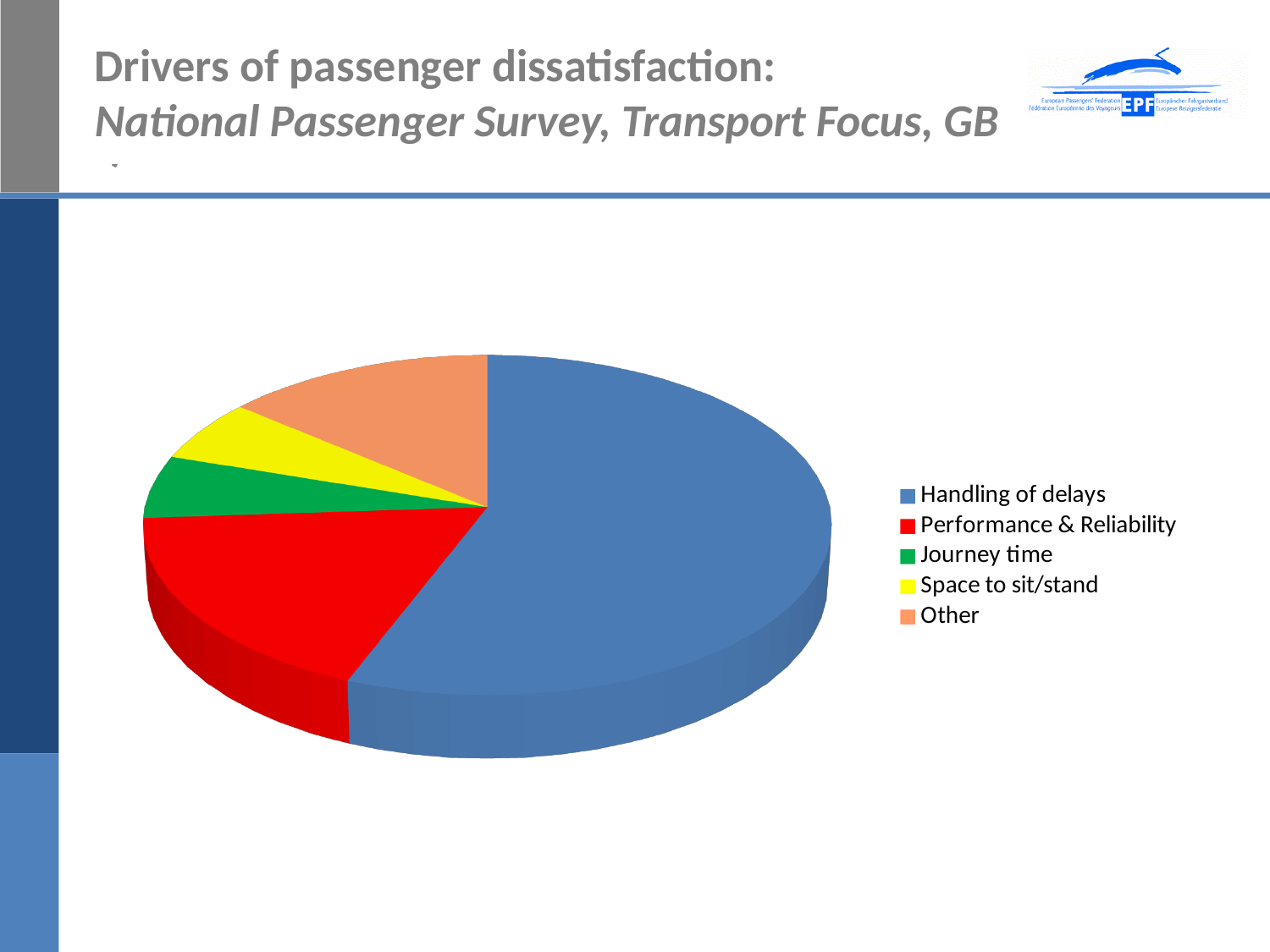
Does the Handling of delays slice make up more or less than half of the pie? More What colour is the Performance & Reliability slice in the pie chart? Red Which slice is larger, Other or Journey time? Other How many categories does the pie chart show? 5 Which slice is larger, Performance & Reliability or Other? Performance & Reliability Which category has the largest slice of the pie chart? Handling of delays Which category is shown in yellow in the pie chart? Space to sit/stand What kind of chart is shown on the slide? Pie chart